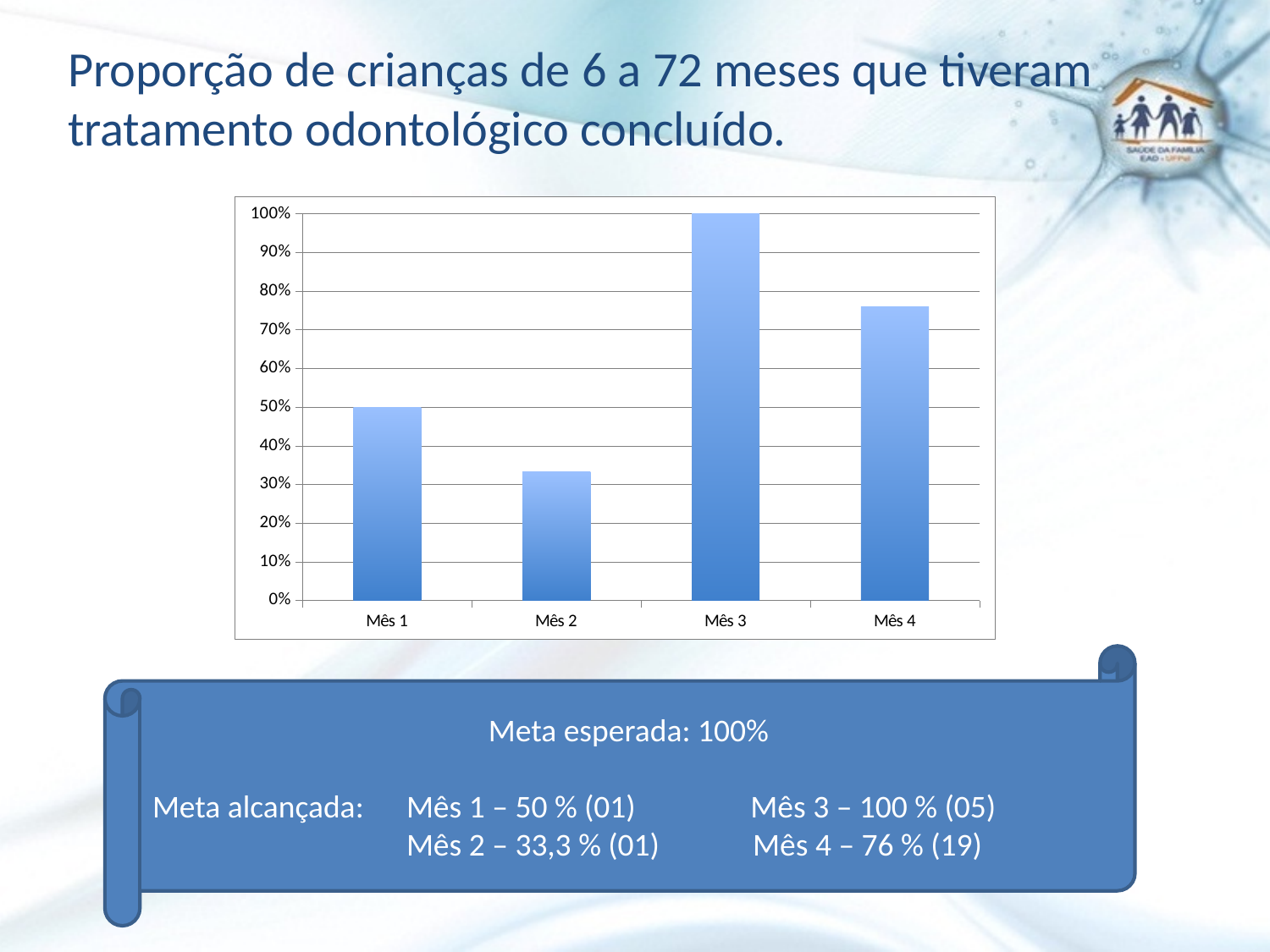
What is the value for Mês 3 in the chart? 100% Which is larger, the value for Mês 1 or the value for Mês 4? Mês 4 Is the value for Mês 2 greater or less than 40%? less What is the difference between the values for Mês 3 and Mês 1? 50% How many categories (months) are shown on the x axis of the chart? 4 What is the value for Mês 1 in the chart? 50% Which month has the highest value in the chart? Mês 3 Which month has the lowest value in the chart? Mês 2 What is the 'Meta esperada' (expected target) stated on the slide? 100% What is the highest value shown on the y axis of the chart? 100% Is the value for Mês 4 greater or less than 70%? greater What type of chart is shown on the slide? bar chart